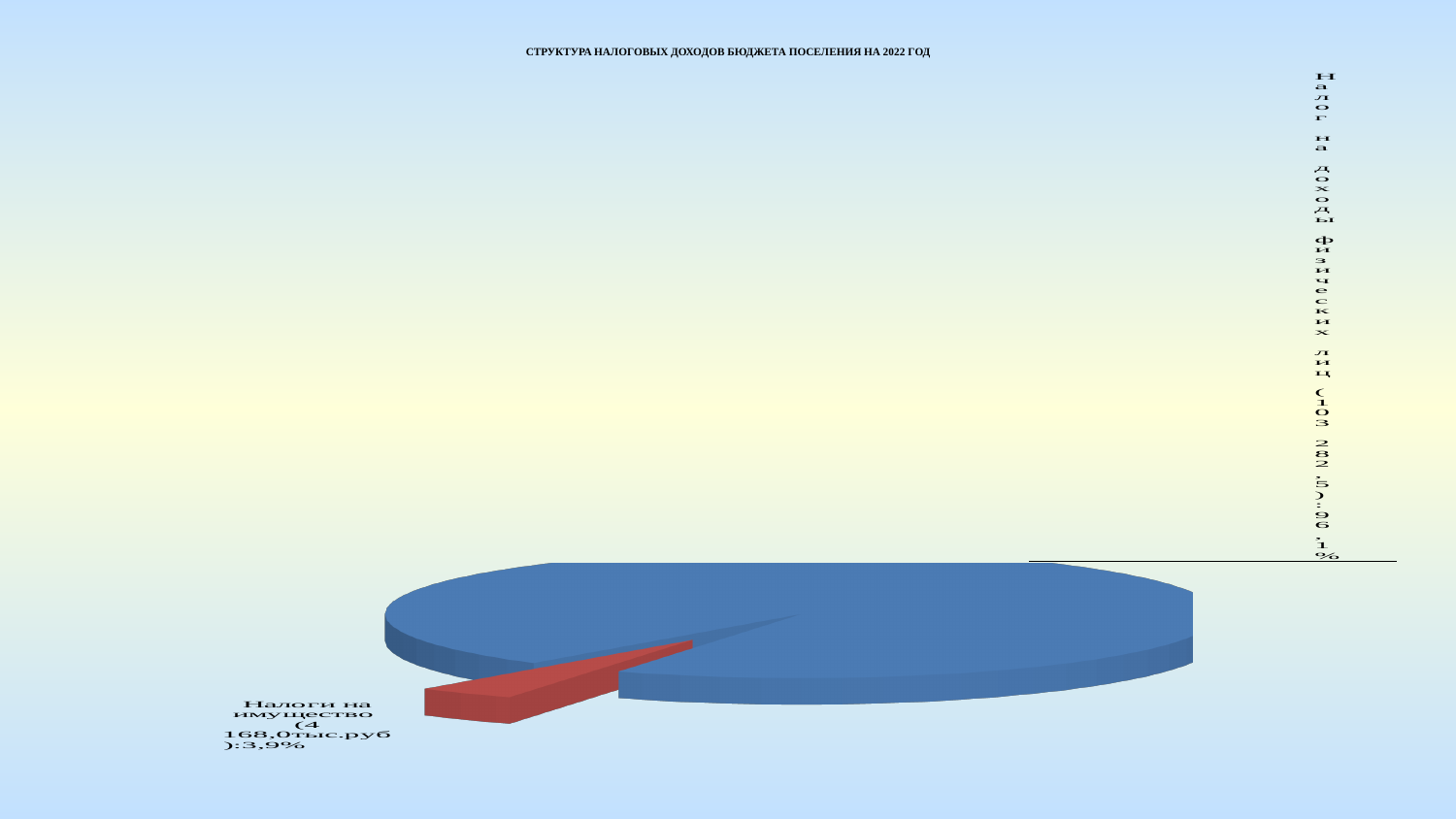
How many slices does the pie chart have? 2 Which is larger, the share for 'Налог на доходы физических лиц' or for 'Налоги на имущество'? Налог на доходы физических лиц What share of the pie is 'Налог на доходы физических лиц'? 96,1% Which slice is the largest? Налог на доходы физических лиц Which slice is the smallest? Налоги на имущество What amount is shown for 'Налоги на имущество'? 4 168,0тыс.руб What kind of chart is shown on the slide? pie chart What amount is shown for 'Налог на доходы физических лиц'? 103 282,5 What is the difference in percentage points between the share of 'Налог на доходы физических лиц' and 'Налоги на имущество'? 92,2% What colour is the slice for 'Налоги на имущество'? red What share of the pie is 'Налоги на имущество'? 3,9% What is the title of the chart? СТРУКТУРА НАЛОГОВЫХ ДОХОДОВ БЮДЖЕТА ПОСЕЛЕНИЯ НА 2022 ГОД